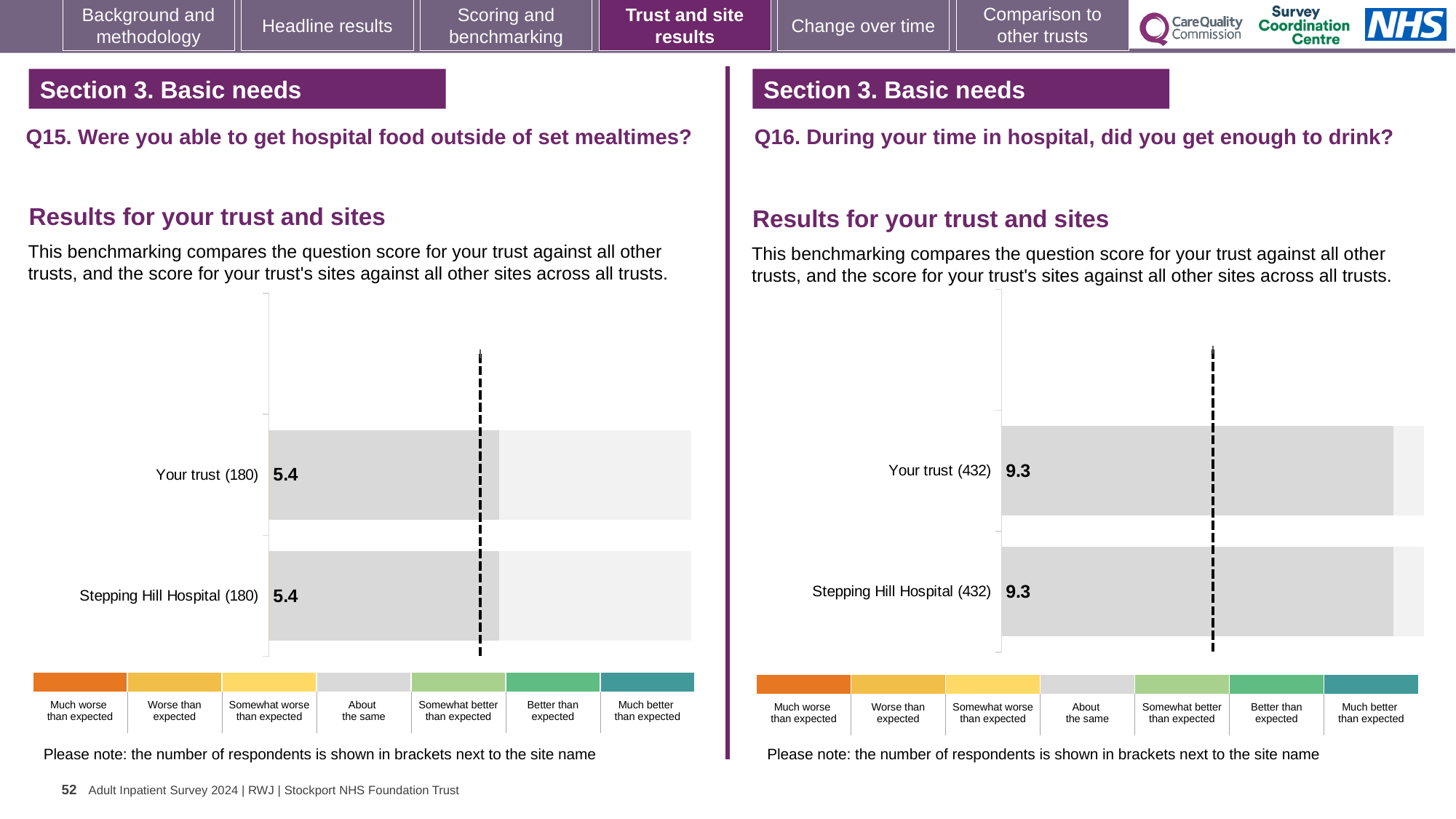
Is the score for Your trust on the Q16 chart (right) larger or smaller than the score for Your trust on the Q15 chart (left)? Larger How many bars are plotted on the Q15 chart (left)? 2 How many bars are plotted on the Q16 chart (right)? 2 On the Q16 chart (right), what is the score for Stepping Hill Hospital? 9.3 On the Q15 chart (left), how many respondents are shown in brackets next to Your trust? 180 On the Q15 chart (left), what is the difference between the score for Your trust and the score for Stepping Hill Hospital? 0 On the Q16 chart (right), how many respondents are shown in brackets next to Stepping Hill Hospital? 432 What kind of chart is used on the Q16 chart (right)? Bar chart On the Q16 chart (right), what is the difference between the score for Your trust and the score for Stepping Hill Hospital? 0 On the Q15 chart (left), what is the score for Your trust? 5.4 On the Q15 chart (left), what is the score for Stepping Hill Hospital? 5.4 On the Q16 chart (right), what is the score for Your trust? 9.3